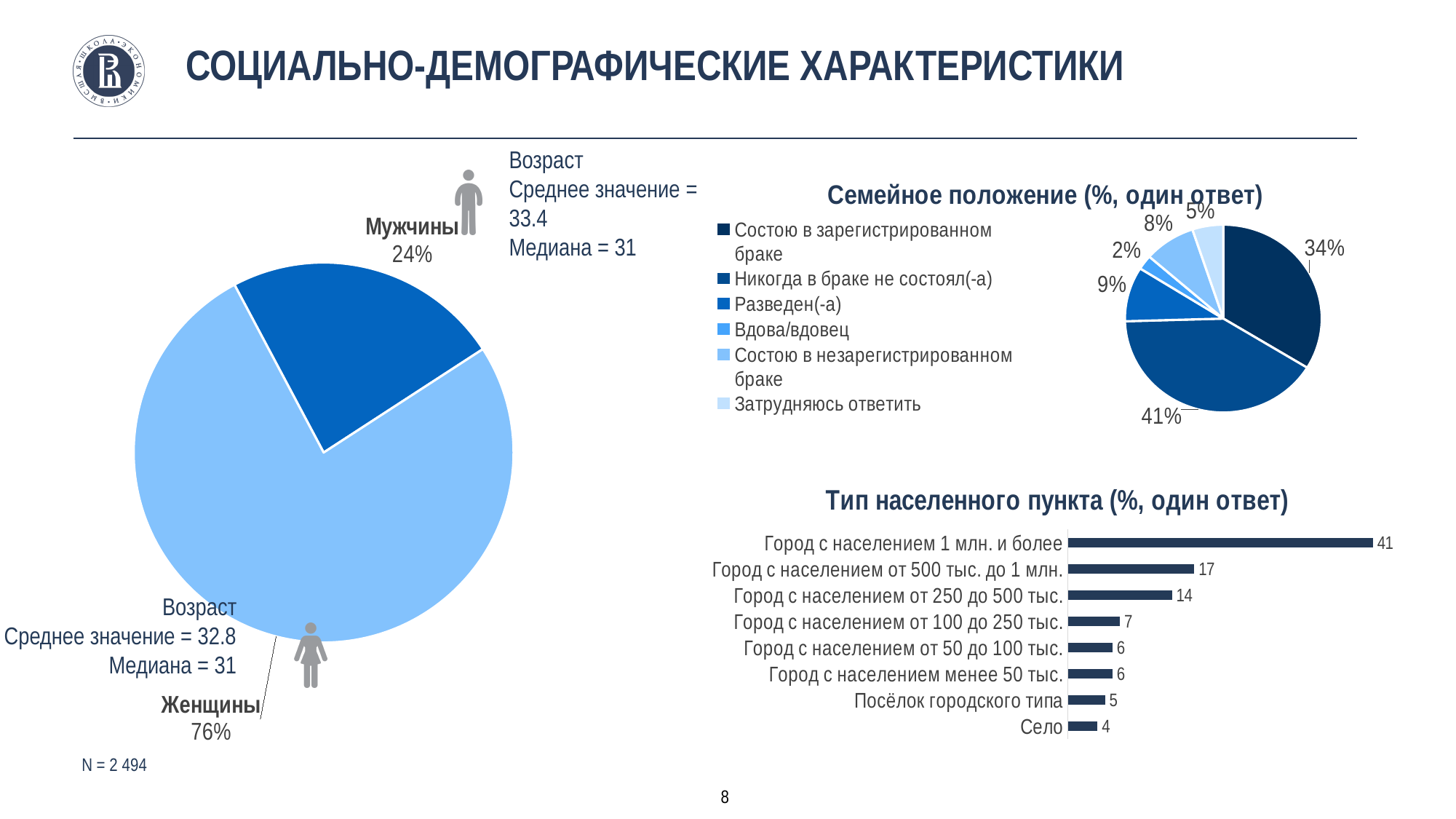
In the left pie chart, what share of respondents are women (Женщины)? 76% In the 'Тип населенного пункта' chart, what is the difference between 'Город с населением от 500 тыс. до 1 млн.' and 'Город с населением от 250 до 500 тыс.'? 3 In the 'Семейное положение' pie chart, what share of respondents are in a registered marriage (Состою в зарегистрированном браке)? 34% In the 'Тип населенного пункта' chart, which category has the lowest value? Село In the left pie chart, what is the difference between the shares of women and men? 52% How many categories does the legend of the 'Семейное положение' pie chart list? 6 In the 'Тип населенного пункта' chart, what is the value for 'Город с населением 1 млн. и более'? 41 In the 'Семейное положение' pie chart, which category has the smallest share? Вдова/вдовец How many categories are shown in the 'Тип населенного пункта' bar chart? 8 In the 'Семейное положение' pie chart, what share of respondents have never been married (Никогда в браке не состоял(-а))? 41% In the left pie chart, what share of respondents are men (Мужчины)? 24% What kind of chart is 'Тип населенного пункта (%, один ответ)'? Bar chart